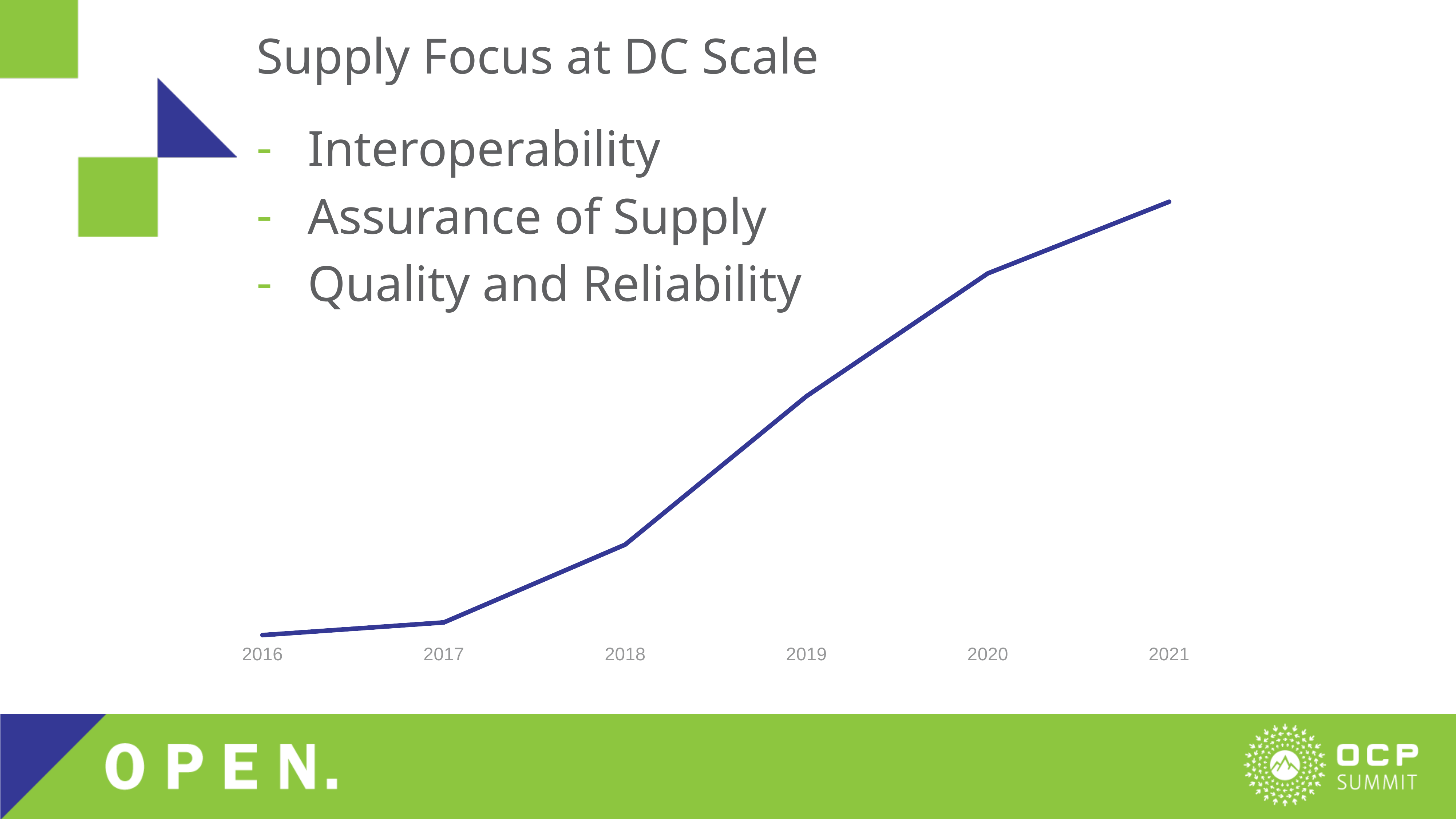
Which is larger in the chart, the value for 2018 or the value for 2020? 2020 What kind of chart is shown on the slide? line chart Which year has the lowest value in the chart? 2016 Which is larger in the chart, the value for 2019 or the value for 2017? 2019 Which year has the highest value in the chart? 2021 Do the values in the chart rise or fall from 2016 to 2021? rise How many years are labelled on the x axis of the chart? 6 Between which two consecutive years does the line in the chart rise the least? 2016 and 2017 What is the first year shown on the x axis of the chart? 2016 What is the last year shown on the x axis of the chart? 2021